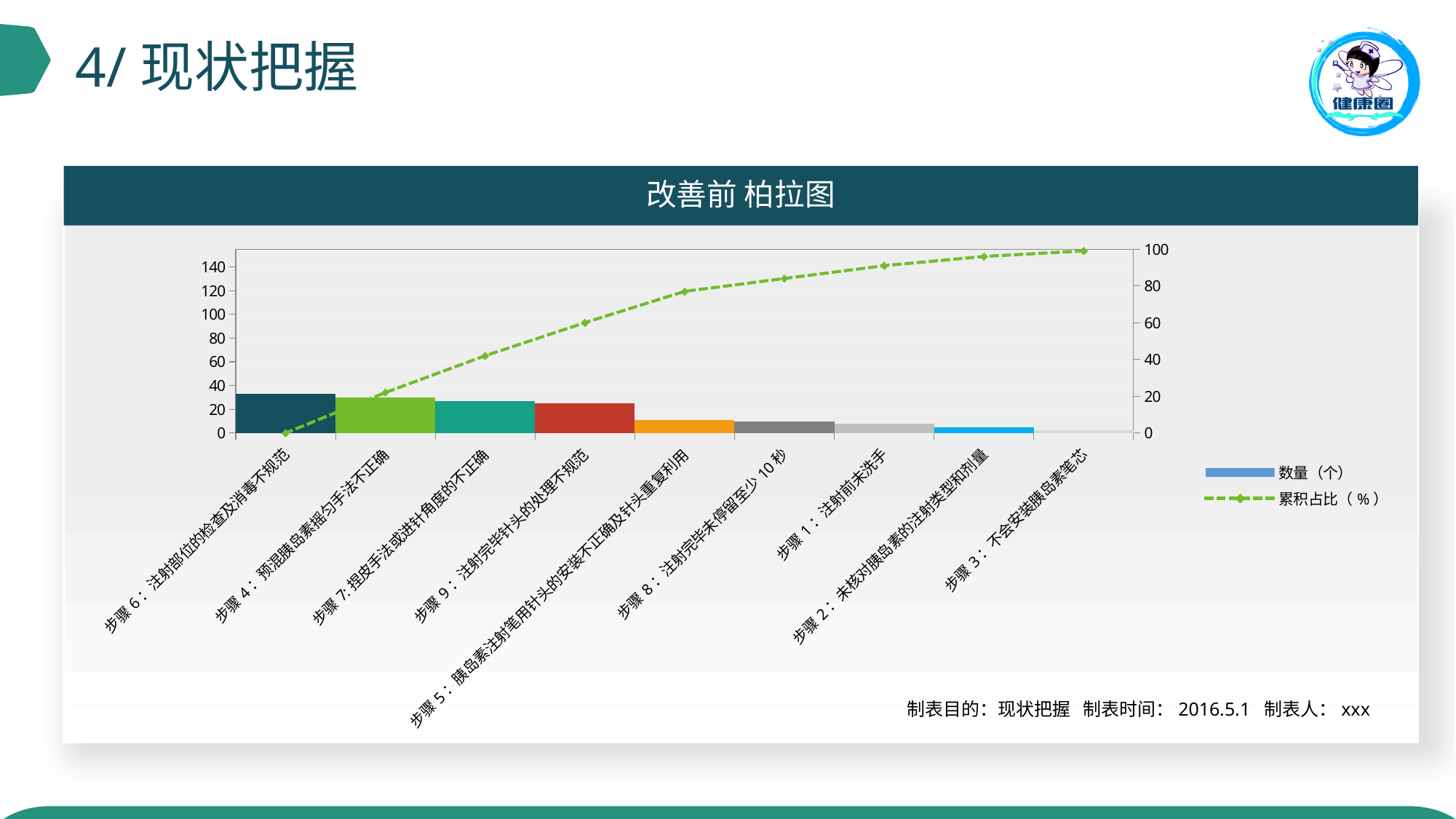
Does the 累积占比（%） line rise or fall from left to right? rise What kind of chart is shown on the slide? Bar chart with a cumulative percentage line (Pareto chart) Is the 数量（个） value for 步骤 6：注射部位的检查及消毒不规范 greater or less than 20? greater How many categories (步骤) are plotted on the x axis? 9 What are the two series named in the legend? 数量（个） and 累积占比（%） Do the 数量（个） bars rise or fall from left to right along the x axis? fall Is the 数量（个） value for 步骤 5：胰岛素注射笔用针头的安装不正确及针头重复利用 greater or less than 20? less Which has the larger 数量（个） bar: 步骤 6：注射部位的检查及消毒不规范 or 步骤 8：注射完毕未停留至少 10 秒? 步骤 6：注射部位的检查及消毒不规范 How many series does the legend list? 2 What is the title of the chart? 改善前 柏拉图 Is the 数量（个） value for 步骤 4：预混胰岛素摇匀手法不正确 greater or less than 20? greater Which category has the lowest 数量（个） bar? 步骤 3：不会安装胰岛素笔芯